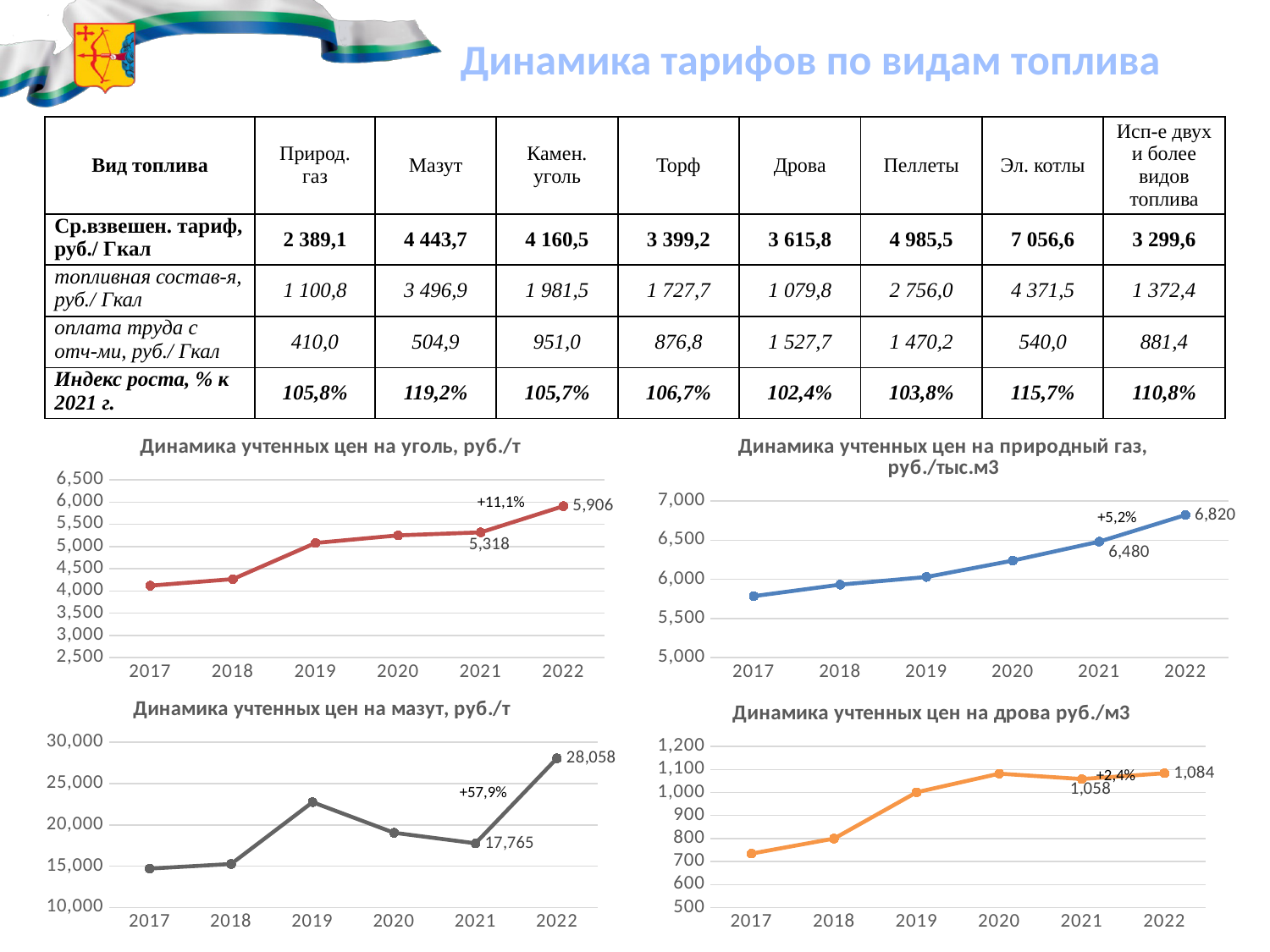
In the chart 'Динамика учтенных цен на мазут, руб./т', is the value for 2019 greater or less than 20,000? greater In the chart 'Динамика учтенных цен на природный газ, руб./тыс.м3', what is the difference between the 2022 and 2021 values? 340 In the chart 'Динамика учтенных цен на уголь, руб./т', by how much did the value increase from 2021 to 2022? 588 How many years are plotted on the x axis of the chart 'Динамика учтенных цен на уголь, руб./т'? 6 In the chart 'Динамика учтенных цен на дрова руб./м3', what is the value for 2021? 1,058 In the chart 'Динамика учтенных цен на природный газ, руб./тыс.м3', which year has the lowest value? 2017 In the chart 'Динамика учтенных цен на уголь, руб./т', what is the value for 2021? 5,318 In the chart 'Динамика учтенных цен на мазут, руб./т', which year has the highest value? 2022 In the chart 'Динамика учтенных цен на дрова руб./м3', is the value for 2018 greater or less than 900? less In the chart 'Динамика учтенных цен на природный газ, руб./тыс.м3', what is the value for 2022? 6,820 In the chart 'Динамика учтенных цен на уголь, руб./т', what is the value for 2022? 5,906 In the chart 'Динамика учтенных цен на мазут, руб./т', what is the value for 2022? 28,058